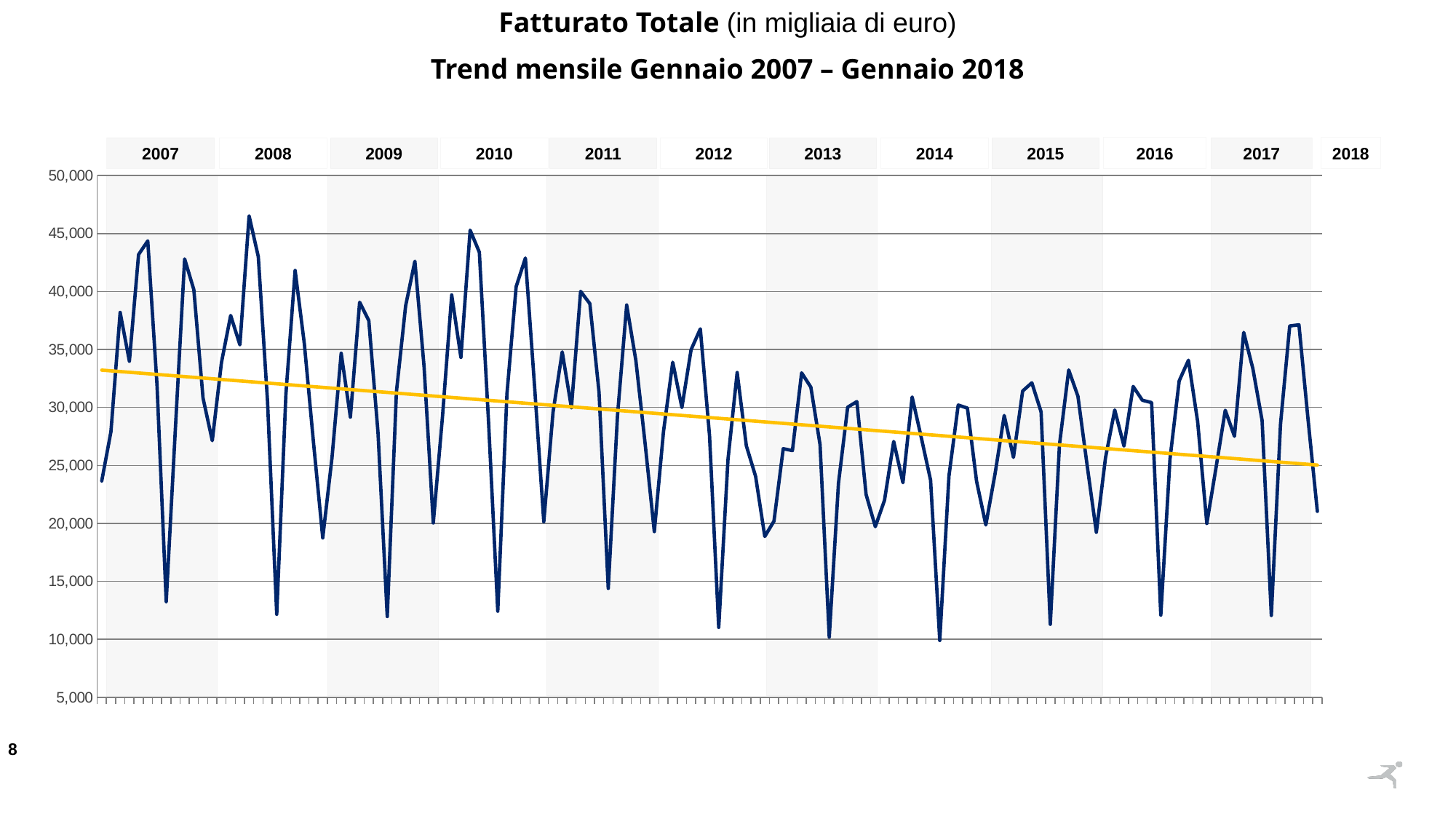
Is the lowest point in 2012 greater or less than 15,000? less Which year contains the highest peak of the blue line, 2008 or 2014? 2008 How many year labels are shown along the top of the chart? 12 What is the highest value shown on the vertical axis? 50,000 Is the value of the yellow trend line at the start of 2018 greater or less than 30,000? less Is the highest peak in 2017 greater or less than 35,000? greater According to the yellow trend line, do the values rise or fall from 2007 to 2018? fall What is the title of the chart? Fatturato Totale (in migliaia di euro) Trend mensile Gennaio 2007 – Gennaio 2018 What kind of chart is shown on the slide? line chart